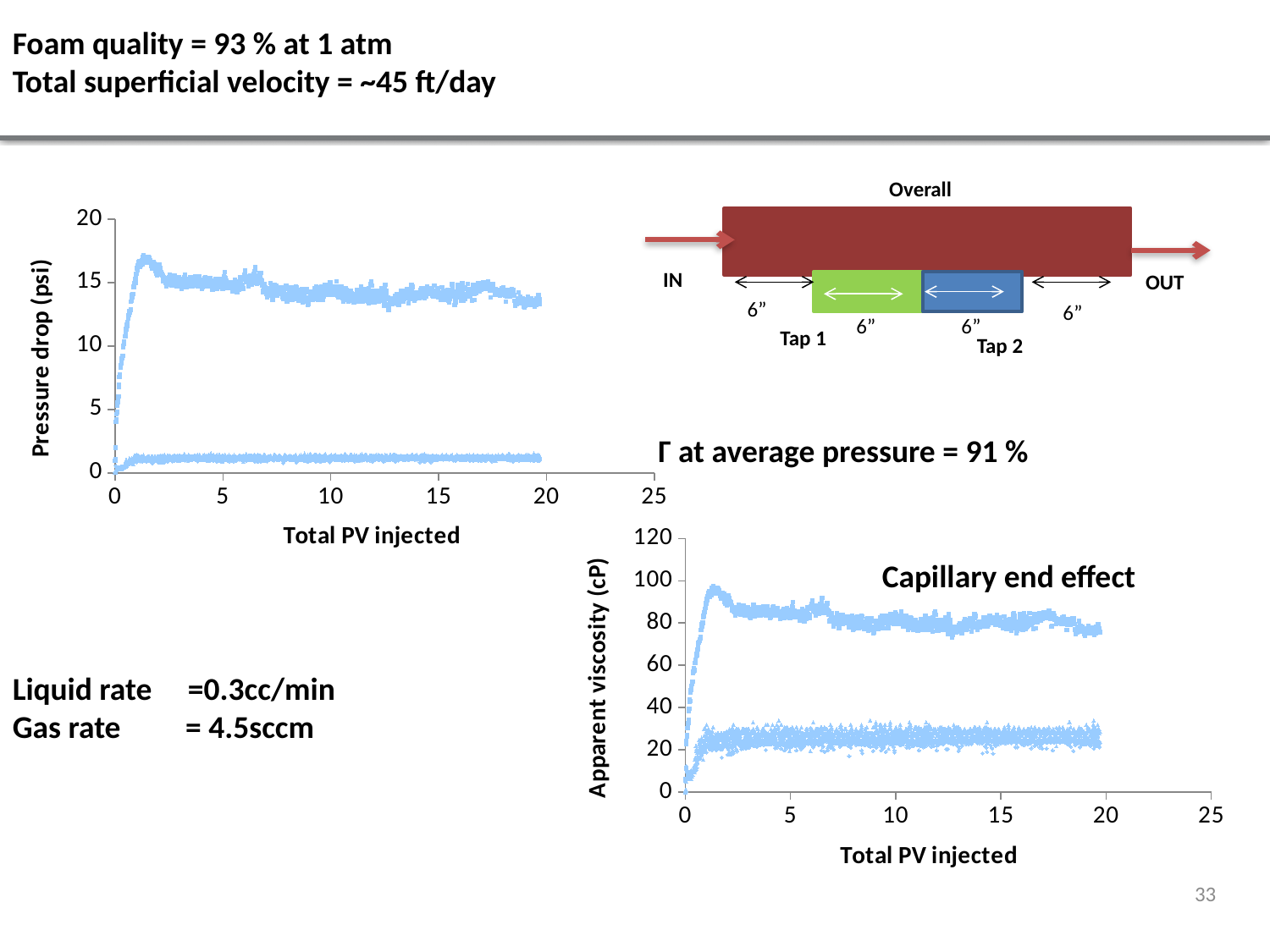
What kind of chart is the chart on the left of the slide (Pressure drop vs Total PV injected)? scatter chart On the left chart, which series has the higher pressure drop at 15 total PV injected, the upper series or the lower series? the upper series On the left chart, what is the label of the y axis? Pressure drop (psi) On the lower-right chart, is the apparent viscosity of the lower series at 10 total PV injected greater or less than 40? less What kind of chart is the chart on the lower right of the slide (Apparent viscosity vs Total PV injected)? scatter chart On the lower-right chart, is the apparent viscosity of the upper series at 10 total PV injected greater or less than 60? greater On the lower-right chart, after its early peak, does the apparent viscosity of the upper series rise or fall as total PV injected increases? fall On the lower-right chart, is the peak apparent viscosity of the upper series greater or less than 100? less On the lower-right chart, what is the label of the y axis? Apparent viscosity (cP)